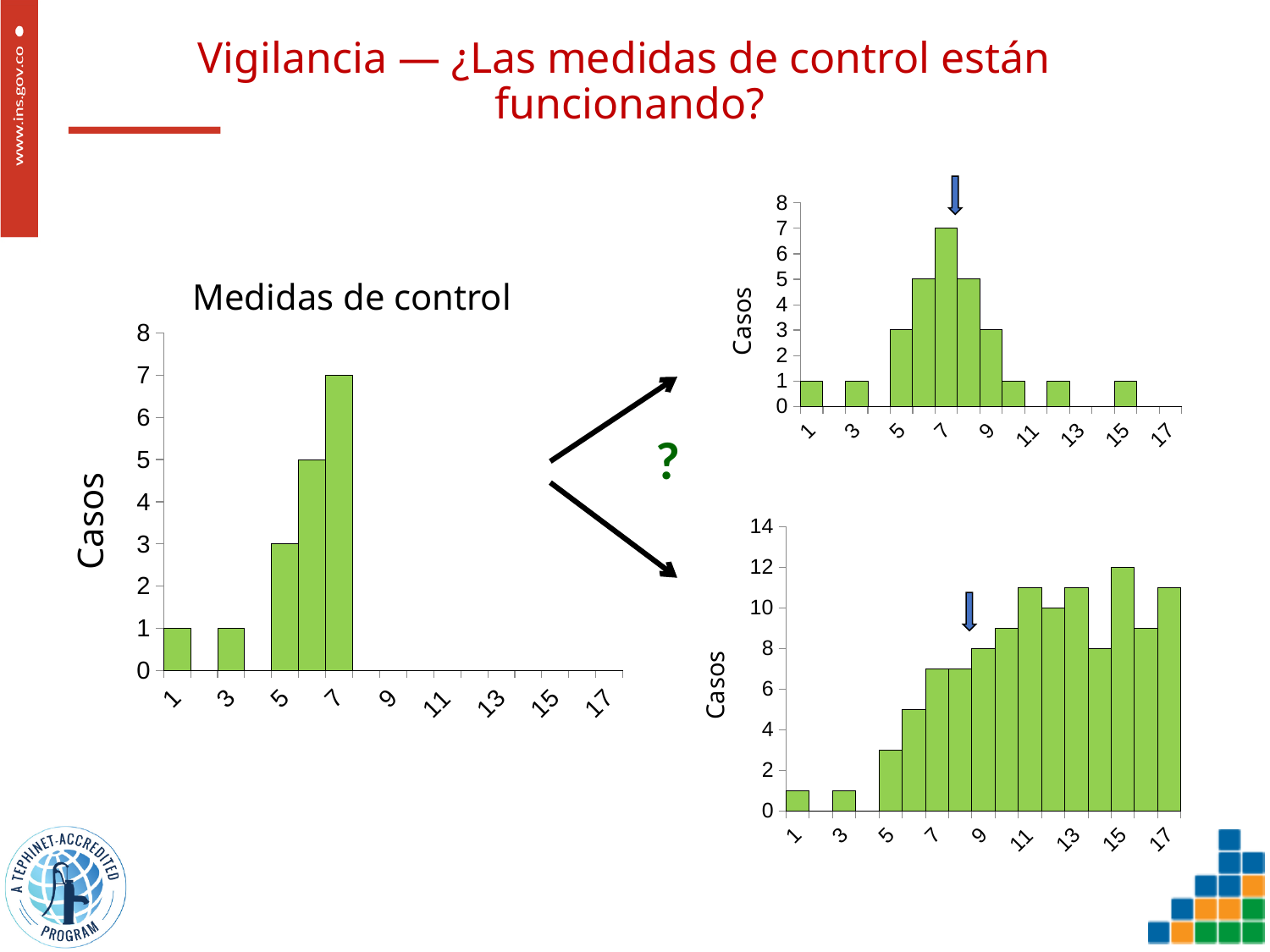
In the bottom-right chart, is the value for day 15 greater or less than 10? greater What kind of chart is the left chart titled 'Medidas de control'? bar chart In the bottom-right chart, is the value for day 3 greater or less than 2? less In the bottom-right chart, do the cases generally rise or fall from day 1 to day 11? rise In the left chart 'Medidas de control', how many cases are shown for day 5? 3 What is the title of the left chart? Medidas de control In the left chart 'Medidas de control', which day has the highest number of cases? 7 In the top-right chart, how many cases are shown for day 9? 3 In the left chart 'Medidas de control', how many cases are shown for day 6? 5 In the left chart 'Medidas de control', what is the difference in cases between day 7 and day 6? 2 In the top-right chart, which day has the highest number of cases? 7 In the top-right chart, which has more cases, day 5 or day 6? day 6